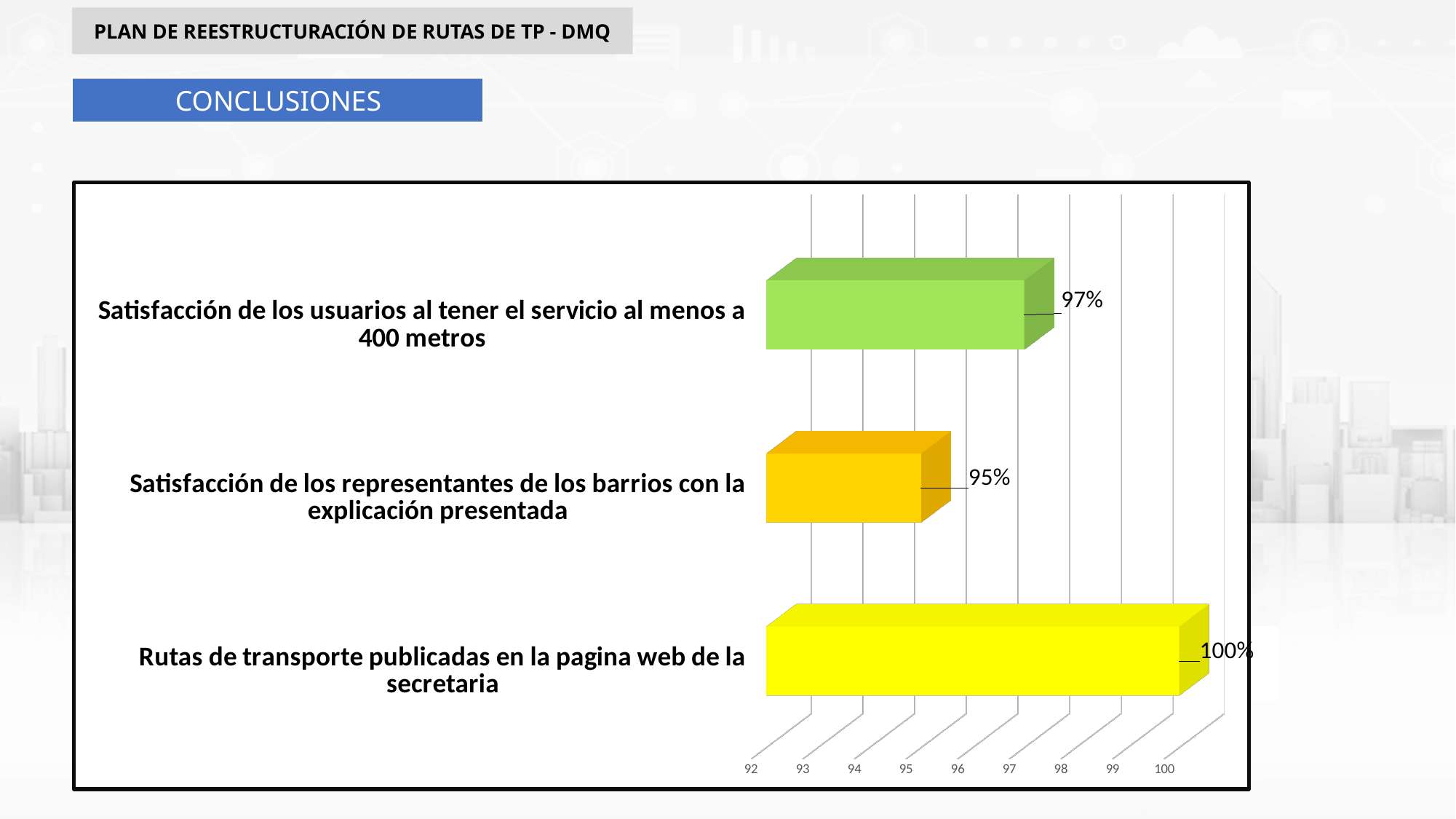
Which is larger: the value for 'Satisfacción de los usuarios al tener el servicio al menos a 400 metros' or the value for 'Satisfacción de los representantes de los barrios con la explicación presentada'? Satisfacción de los usuarios al tener el servicio al menos a 400 metros What kind of chart is shown on the slide? Bar chart What is the difference between the value for 'Rutas de transporte publicadas en la pagina web de la secretaria' and the value for 'Satisfacción de los representantes de los barrios con la explicación presentada'? 5% How many categories are shown in the chart? 3 Is the value for 'Satisfacción de los representantes de los barrios con la explicación presentada' greater or less than 96? less What is the value for 'Satisfacción de los usuarios al tener el servicio al menos a 400 metros'? 97% What is the difference between the value for 'Satisfacción de los usuarios al tener el servicio al menos a 400 metros' and the value for 'Satisfacción de los representantes de los barrios con la explicación presentada'? 2% What is the value for 'Rutas de transporte publicadas en la pagina web de la secretaria'? 100% Which category has the highest value? Rutas de transporte publicadas en la pagina web de la secretaria What is the value for 'Satisfacción de los representantes de los barrios con la explicación presentada'? 95% Which category has the lowest value? Satisfacción de los representantes de los barrios con la explicación presentada What is the lowest value shown on the horizontal axis of the chart? 92